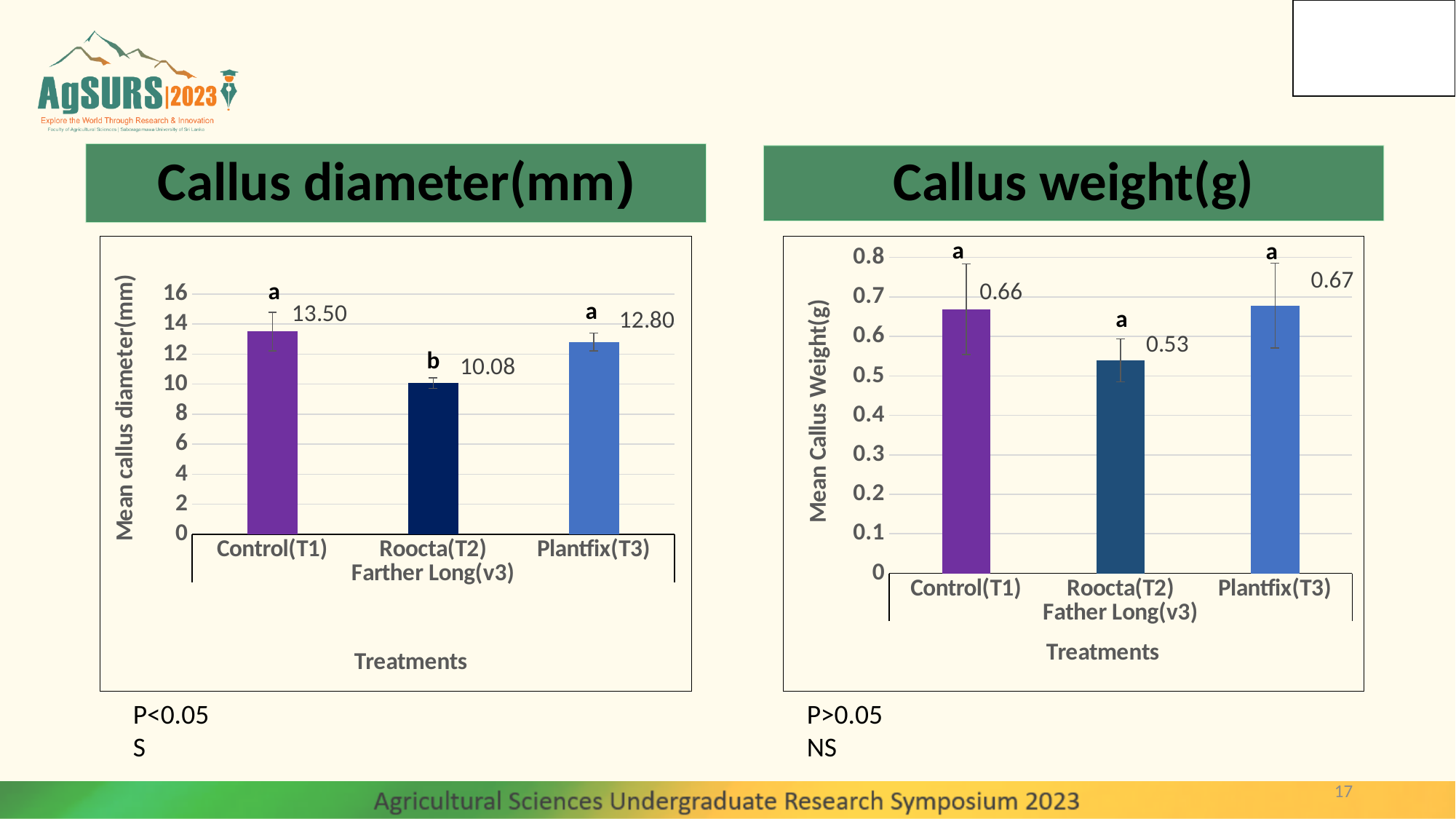
In the Callus diameter(mm) chart, what is the value for Roocta(T2)? 10.08 In the Callus diameter(mm) chart, which treatment has the lowest mean callus diameter? Roocta(T2) In the Callus diameter(mm) chart, is the value for Roocta(T2) greater or less than 12? less In the Callus diameter(mm) chart, what is the difference between Control(T1) and Plantfix(T3)? 0.70 How many treatments are shown in the Callus weight(g) chart? 3 In the Callus diameter(mm) chart, what is the value for Control(T1)? 13.50 In the Callus weight(g) chart, what is the value for Plantfix(T3)? 0.67 In the Callus weight(g) chart, which treatment has the highest mean callus weight? Plantfix(T3) In the Callus weight(g) chart, what is the difference between Control(T1) and Roocta(T2)? 0.13 In the Callus weight(g) chart, which is larger, the value for Control(T1) or Roocta(T2)? Control(T1) What type of chart is the Callus diameter(mm) chart? Bar chart In the Callus weight(g) chart, what is the value for Roocta(T2)? 0.53